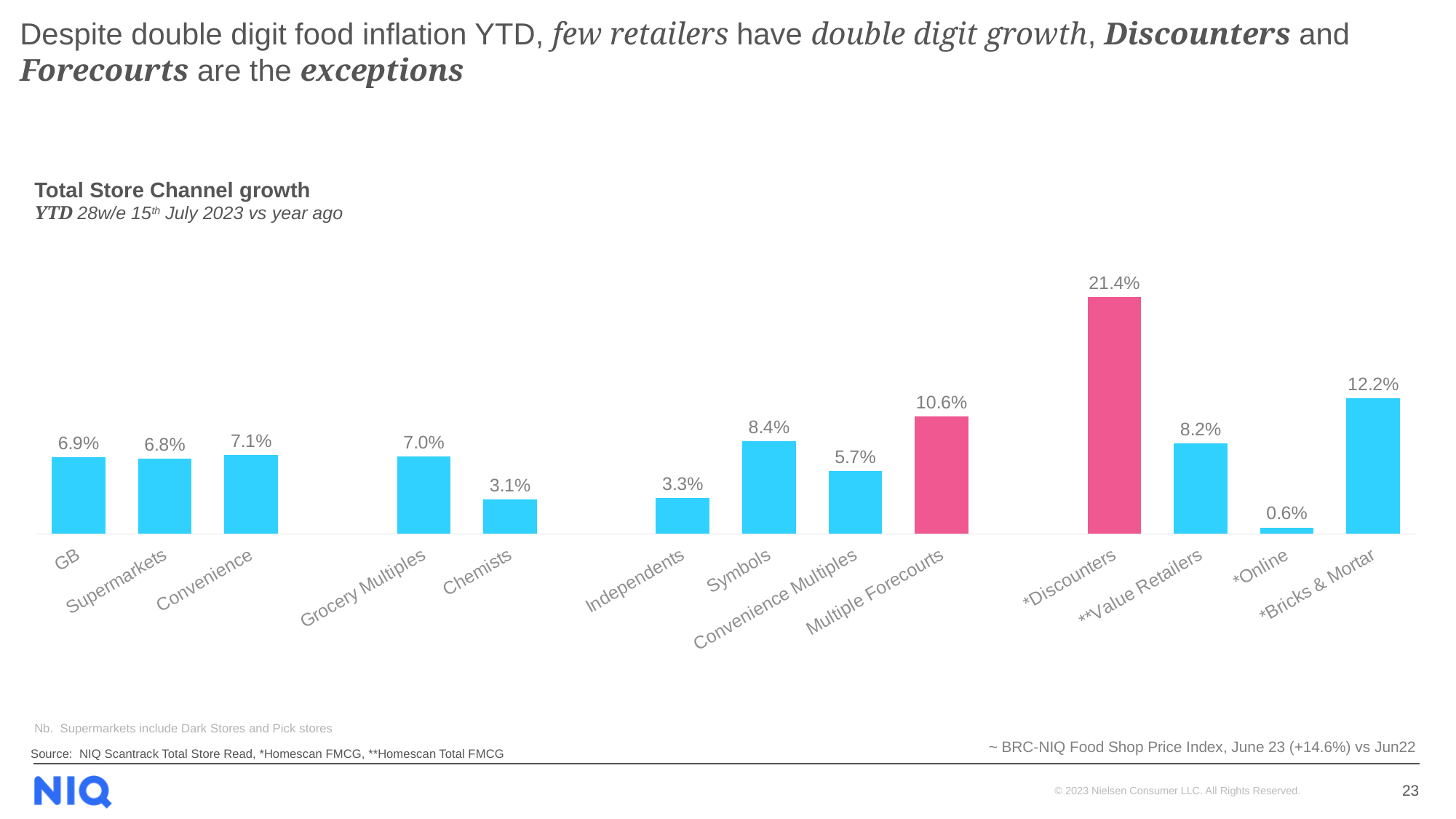
Which channel has the lowest growth? *Online What is the growth value for *Online? 0.6% What is the growth value for Multiple Forecourts? 10.6% What is the difference between the growth for Symbols and Convenience Multiples? 2.7% What is the growth value for *Discounters? 21.4% Which channel has the highest growth? *Discounters What is the growth value for Chemists? 3.1% How many channels are shown in the chart? 13 Which has higher growth, Independents or Symbols? Symbols What kind of chart is shown on the slide? Bar chart Which two bars are highlighted in pink rather than blue? Multiple Forecourts and *Discounters What is the difference between the growth for *Discounters and *Bricks & Mortar? 9.2%